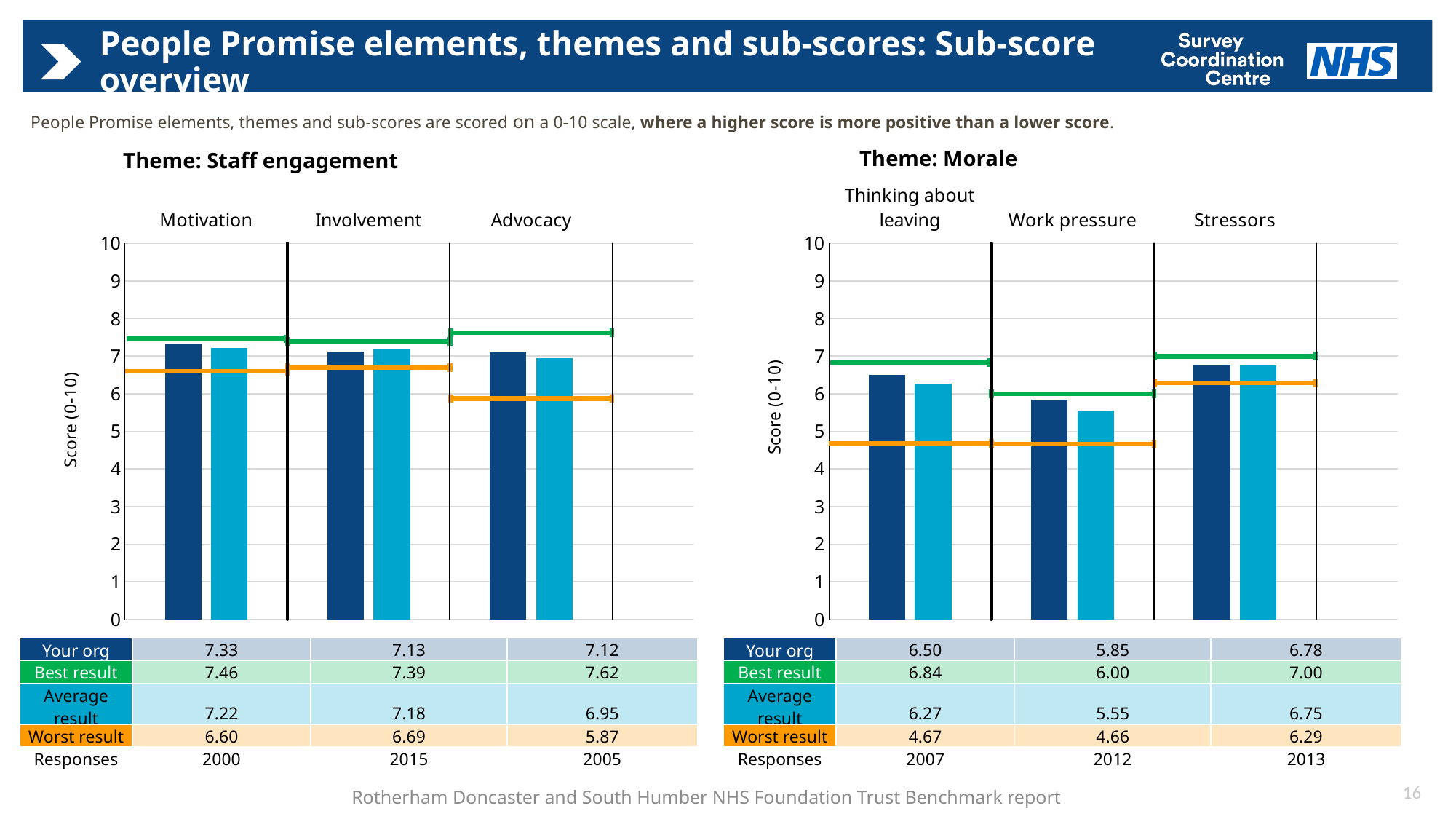
On the Theme: Morale chart, how many sub-scores are shown? 3 On the Theme: Morale chart, how many responses are recorded for Thinking about leaving? 2007 On the Theme: Morale chart, which sub-score has the lowest Your org value? Work pressure On the Theme: Morale chart, what is the Worst result for Work pressure? 4.66 On the Theme: Staff engagement chart, what is the difference between the Best result and the Worst result for Advocacy? 1.75 On the Theme: Staff engagement chart, what is the Your org score for Motivation? 7.33 On the Theme: Staff engagement chart, which sub-score has the highest Your org value? Motivation On the Theme: Staff engagement chart, is the Your org value for Involvement greater or less than 7? greater On the Theme: Morale chart, what is the difference between the Your org score and the Average result for Thinking about leaving? 0.23 On the Theme: Morale chart, which is larger for Stressors: the Your org score or the Average result? Your org What kind of chart is used for the Theme: Staff engagement data? Bar chart On the Theme: Morale chart, which sub-score has the highest Best result? Stressors